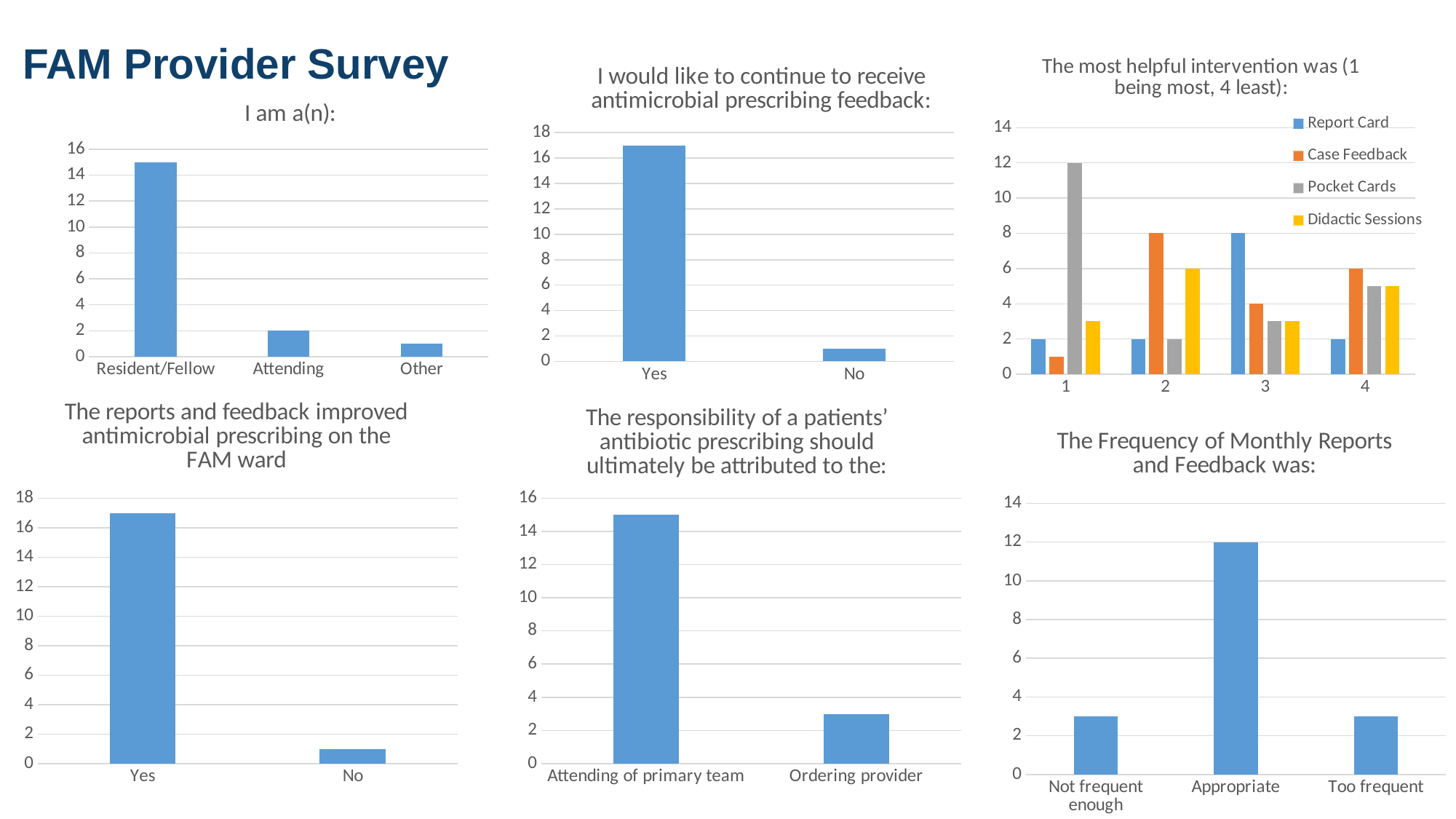
In the chart titled "The responsibility of a patients' antibiotic prescribing should ultimately be attributed to the:", how many categories are shown? 2 In the chart titled "I am a(n):", which category has the highest value? Resident/Fellow In the chart titled "I am a(n):", what is the value for Attending? 2 In the chart titled "The most helpful intervention was (1 being most, 4 least):", what is the difference between Pocket Cards and Report Card at rank 1? 10 In the chart titled "The most helpful intervention was (1 being most, 4 least):", how many series does the legend list? 4 In the chart titled "The reports and feedback improved antimicrobial prescribing on the FAM ward", is the value for No greater or less than 2? less In the chart titled "The most helpful intervention was (1 being most, 4 least):", what is the value for Pocket Cards at rank 1? 12 In the chart titled "I would like to continue to receive antimicrobial prescribing feedback:", which is larger, Yes or No? Yes In the chart titled "I would like to continue to receive antimicrobial prescribing feedback:", is the value for Yes greater or less than 16? greater In the chart titled "The most helpful intervention was (1 being most, 4 least):", which series has the highest value at rank 3? Report Card In the chart titled "The most helpful intervention was (1 being most, 4 least):", what is the value for Case Feedback at rank 2? 8 In the chart titled "The Frequency of Monthly Reports and Feedback was:", what is the value for Appropriate? 12